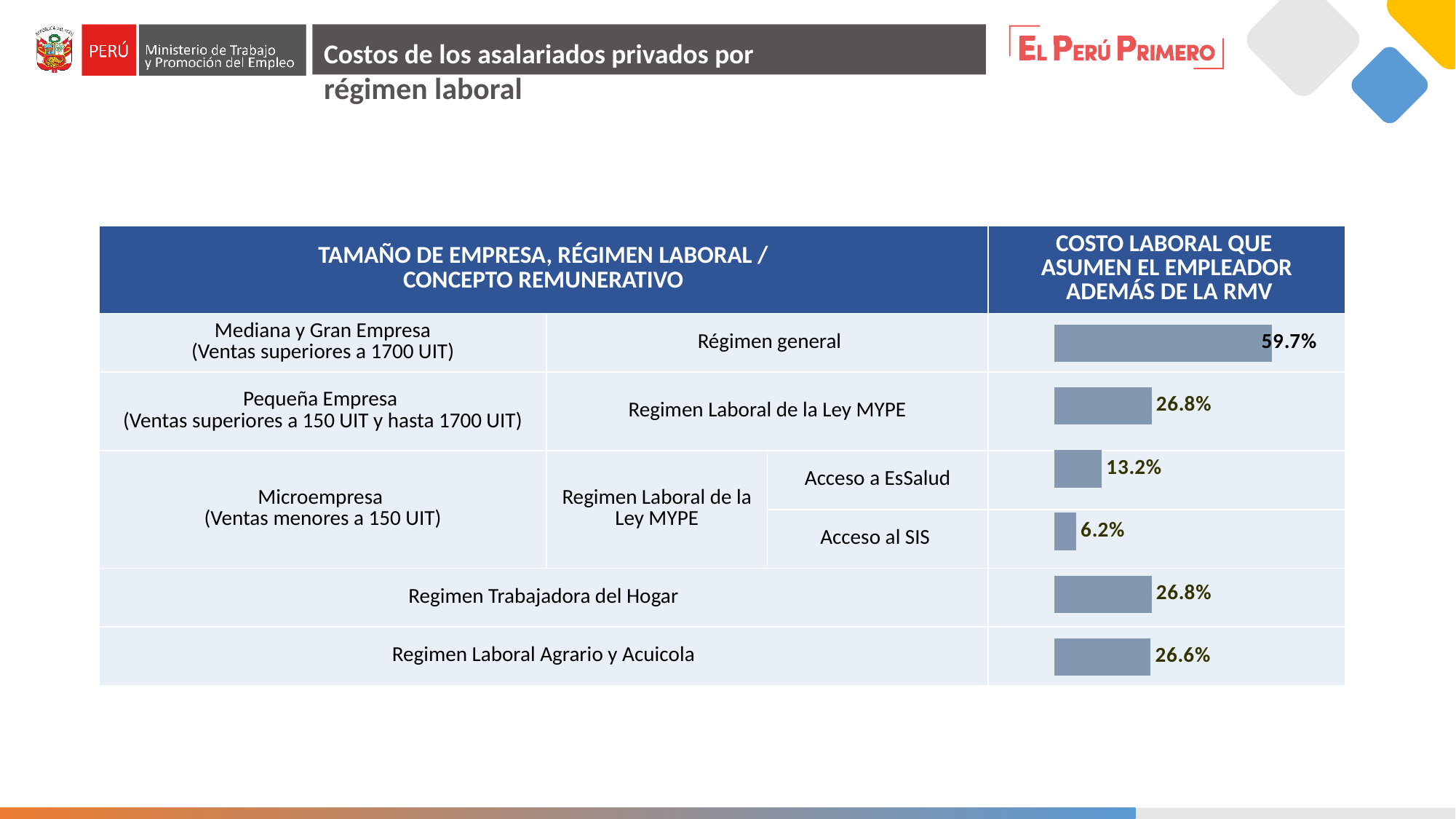
How many bars are shown in the labour cost column? 6 What is the labour cost assumed by the employer in addition to the RMV for the Régimen general (Mediana y Gran Empresa)? 59.7% What is the difference between the Acceso a EsSalud value and the Acceso al SIS value for Microempresa? 7.0% Which regime has the highest labour cost assumed by the employer in addition to the RMV? Régimen general Which is larger, the value for Regimen Trabajadora del Hogar or the value for Regimen Laboral Agrario y Acuicola? Regimen Trabajadora del Hogar What is the difference between the Régimen general value and the Regimen Trabajadora del Hogar value? 32.9% What kind of chart is used to show the labour cost values? Bar chart What is the value shown for the Regimen Laboral de la Ley MYPE for Pequeña Empresa? 26.8% What is the value shown for the Regimen Laboral Agrario y Acuicola? 26.6% What is the value shown for Microempresa with Acceso a EsSalud? 13.2% What is the value shown for Microempresa with Acceso al SIS? 6.2% Which row has the lowest labour cost value? Acceso al SIS